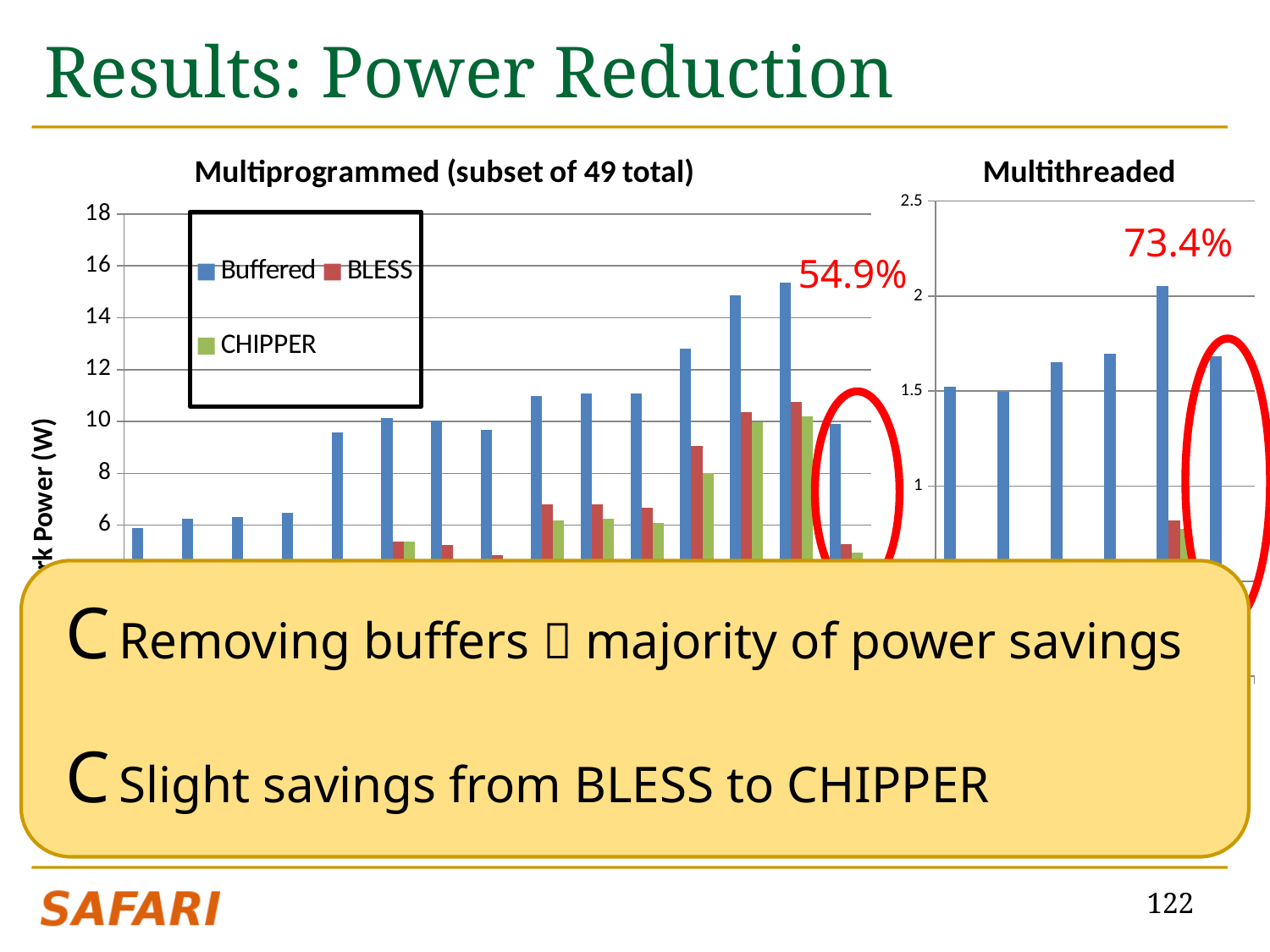
In the Multiprogrammed (subset of 49 total) chart, which series has the shortest bars? CHIPPER What kind of chart is the Multiprogrammed (subset of 49 total) chart? bar chart In the Multithreaded chart, is the tallest BLESS bar greater or less than 1? less How many series does the legend of the Multiprogrammed (subset of 49 total) chart list? 3 In the Multiprogrammed (subset of 49 total) chart, is the tallest Buffered bar greater or less than 14? greater What is the highest value shown on the y axis of the Multiprogrammed (subset of 49 total) chart? 18 What are the series names in the legend of the Multiprogrammed (subset of 49 total) chart? Buffered, BLESS, CHIPPER In the Multiprogrammed (subset of 49 total) chart, is the tallest CHIPPER bar greater or less than 12? less How many Buffered bars are shown in the Multithreaded chart? 6 What kind of chart is the Multithreaded chart? bar chart In the Multiprogrammed (subset of 49 total) chart, which series has the tallest bars? Buffered